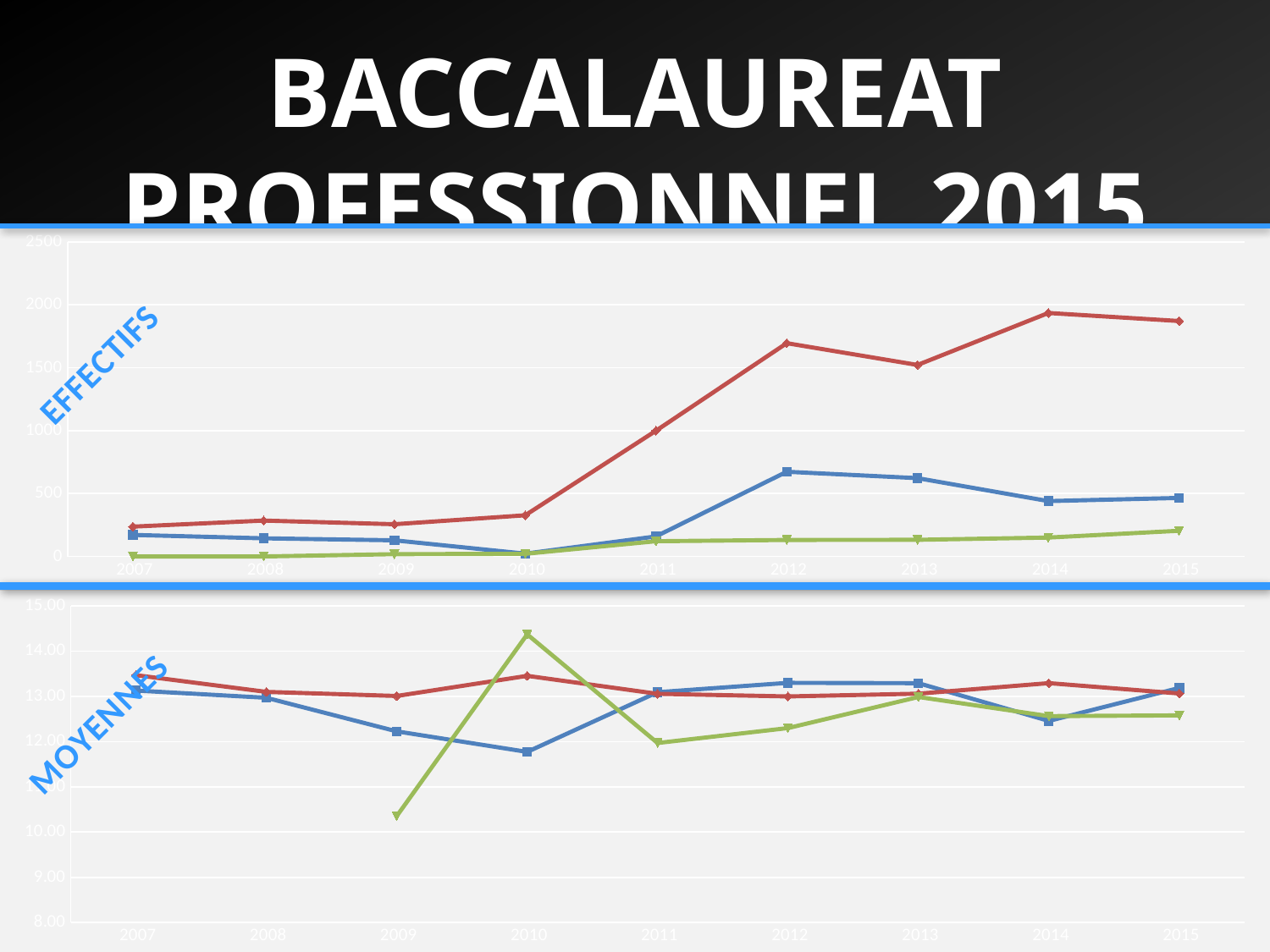
What type of chart is the top chart labelled EFFECTIFS? line chart In the top chart (EFFECTIFS), which line is higher in 2012, the red line or the blue line? the red line In the bottom chart (MOYENNES), in which year does the green line reach its lowest value? 2009 In the bottom chart (MOYENNES), is the value of the green line in 2009 greater or less than 11.00? less In the bottom chart (MOYENNES), which line is higher in 2010, the green line or the blue line? the green line In the top chart (EFFECTIFS), is the value of the red line in 2015 greater or less than 1500? greater In the top chart (EFFECTIFS), in which year does the blue line reach its highest value? 2012 In the top chart (EFFECTIFS), is the value of the blue line in 2012 greater or less than 500? greater In the top chart (EFFECTIFS), in which year does the red line reach its highest value? 2014 In the top chart (EFFECTIFS), does the red line overall rise or fall from 2007 to 2015? rise How many years are shown on the x axis of the top chart (EFFECTIFS)? 9 In the bottom chart (MOYENNES), in which year does the green line reach its highest value? 2010